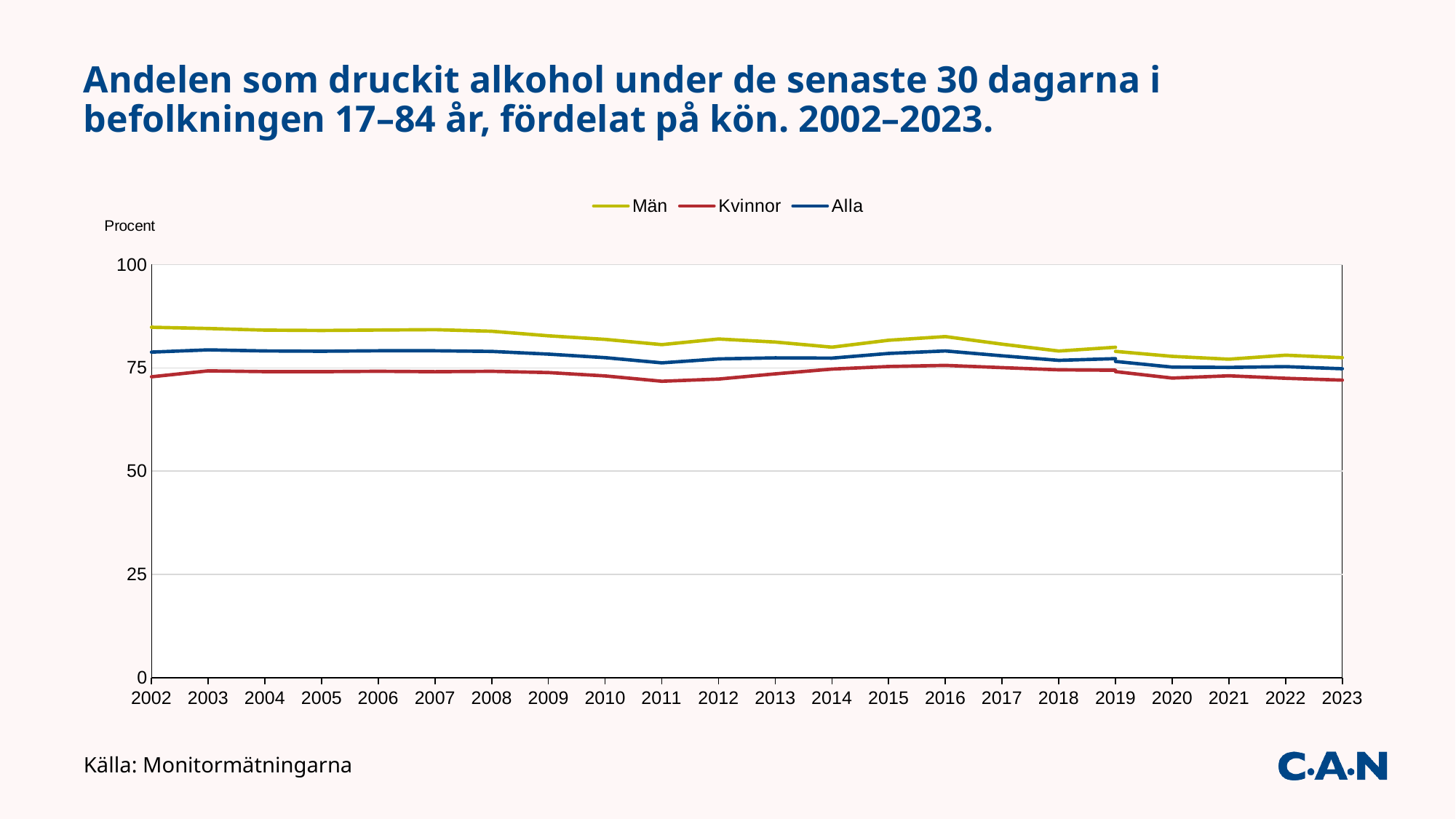
How many series does the legend list? 3 Is the value for Kvinnor in 2020 greater or less than 75? less What label is shown on the y axis? Procent Is the value for Kvinnor in 2011 greater or less than 75? less Which series has the lowest values across the whole period? Kvinnor In 2002, which is larger: the value for Män or the value for Kvinnor? Män What kind of chart is shown on the slide? line chart Does the Män series rise or fall from 2002 to 2023? fall How many years are plotted along the x axis? 22 Which series has the highest values across the whole period? Män Is the value for Alla in 2002 greater or less than 75? greater